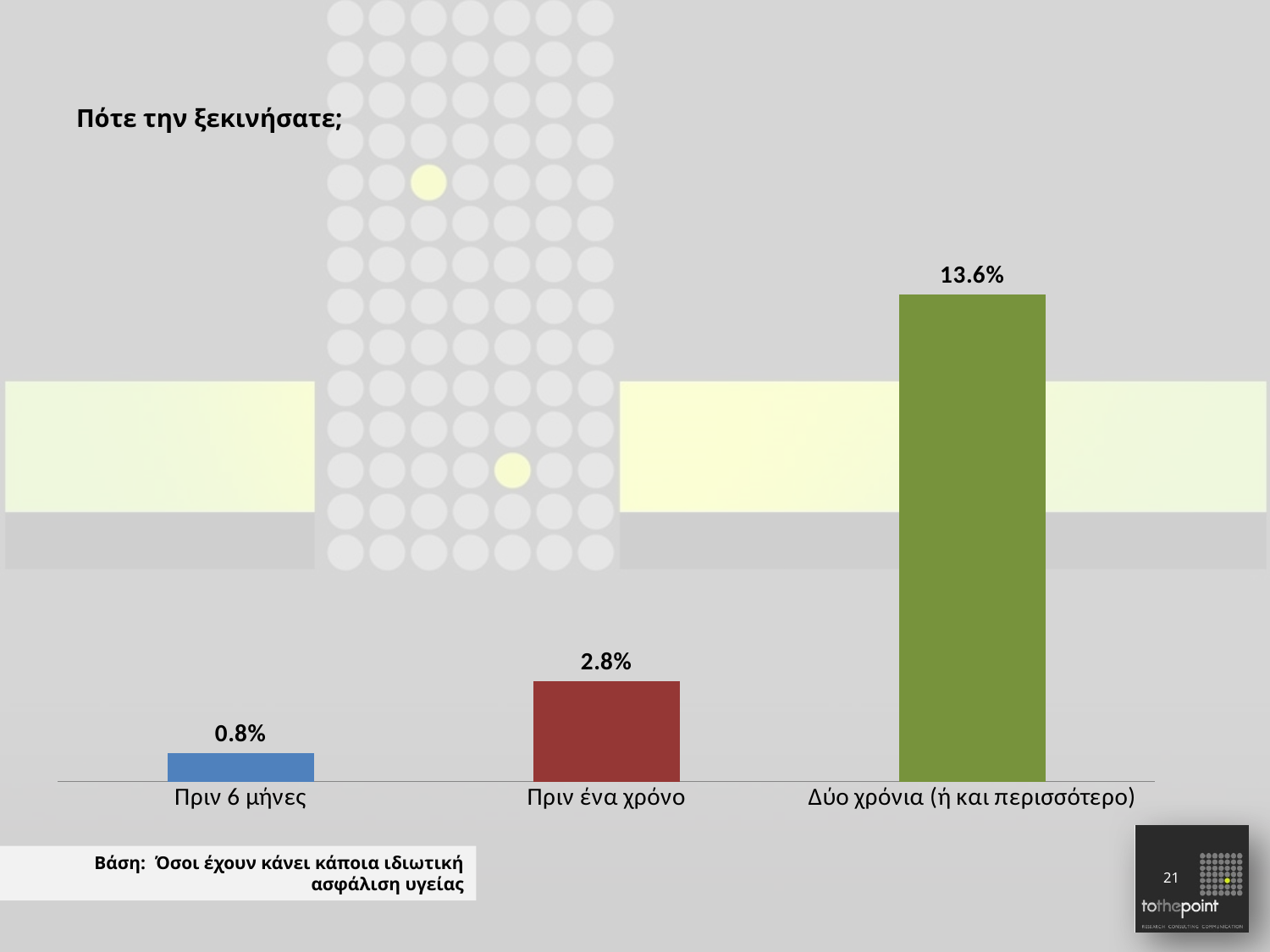
What is the difference between the values for Δύο χρόνια (ή και περισσότερο) and Πριν ένα χρόνο? 10.8% Which category has the highest value? Δύο χρόνια (ή και περισσότερο) What is the value for Πριν ένα χρόνο? 2.8% Do the values rise or fall from left to right along the x axis? Rise What kind of chart is shown on the slide? Bar chart How many categories are shown in the chart? 3 What is the difference between the values for Πριν ένα χρόνο and Πριν 6 μήνες? 2.0% What is the title of the chart? Πότε την ξεκινήσατε; Which category has the lowest value? Πριν 6 μήνες Which is larger, the value for Πριν ένα χρόνο or the value for Πριν 6 μήνες? Πριν ένα χρόνο What is the value for Πριν 6 μήνες? 0.8% What is the value for Δύο χρόνια (ή και περισσότερο)? 13.6%